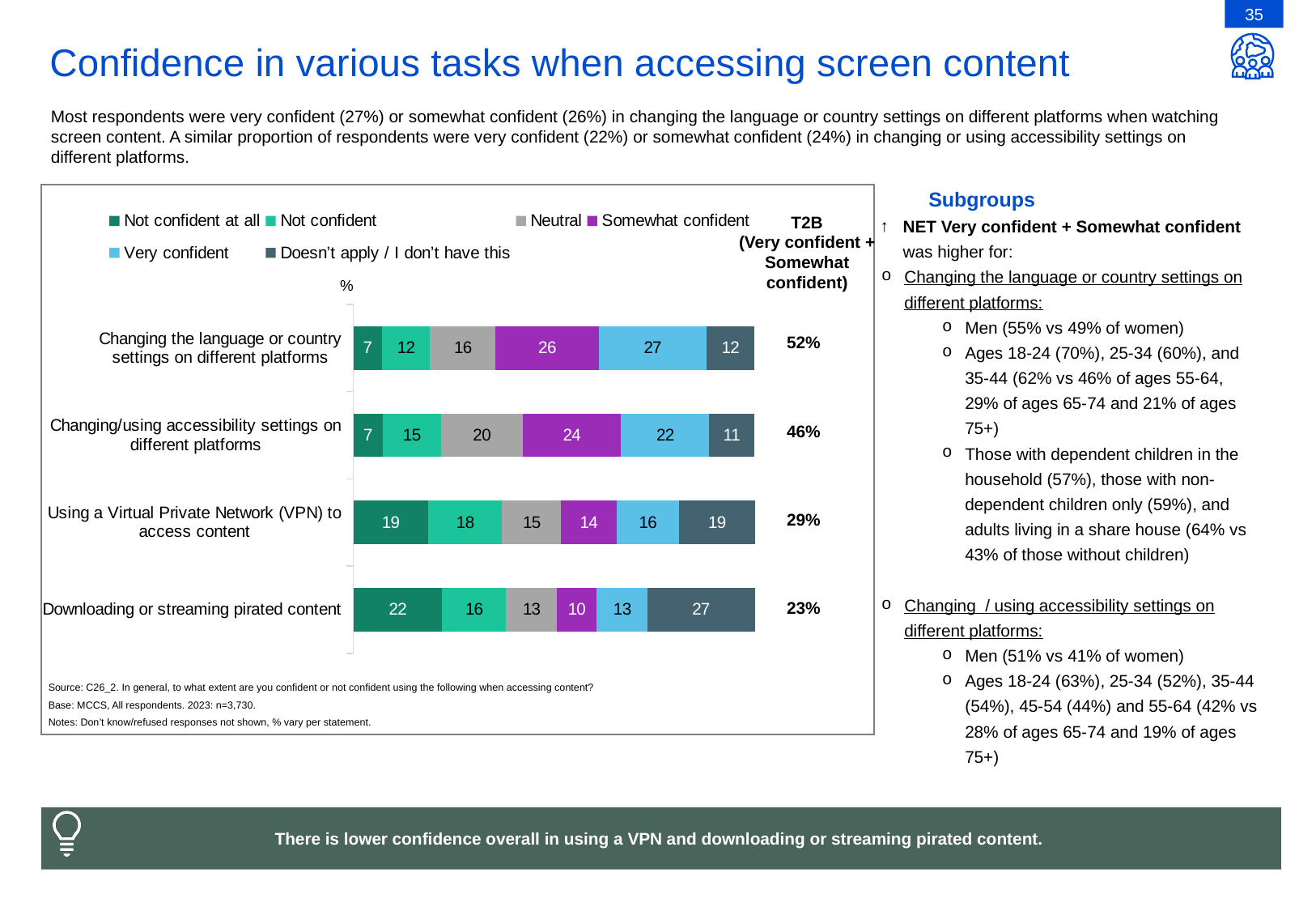
Which task has the lowest 'Very confident' value? Downloading or streaming pirated content How many series does the legend list? 6 What is the T2B (Very confident + Somewhat confident) value for 'Using a Virtual Private Network (VPN) to access content'? 29% Which is larger: the 'Doesn't apply / I don't have this' value for 'Downloading or streaming pirated content' or for 'Using a Virtual Private Network (VPN) to access content'? Downloading or streaming pirated content What kind of chart is shown on the slide? Stacked bar chart What is the 'Not confident at all' value for 'Downloading or streaming pirated content'? 22 Which task has the highest T2B (Very confident + Somewhat confident) value? Changing the language or country settings on different platforms What is the 'Somewhat confident' value for 'Changing/using accessibility settings on different platforms'? 24 How many tasks (categories) are plotted in the chart? 4 What is the total of all segments in the bar for 'Changing the language or country settings on different platforms'? 100 What is the difference between the 'Neutral' values for 'Changing/using accessibility settings on different platforms' and 'Changing the language or country settings on different platforms'? 4 What is the 'Very confident' value for 'Changing the language or country settings on different platforms'? 27